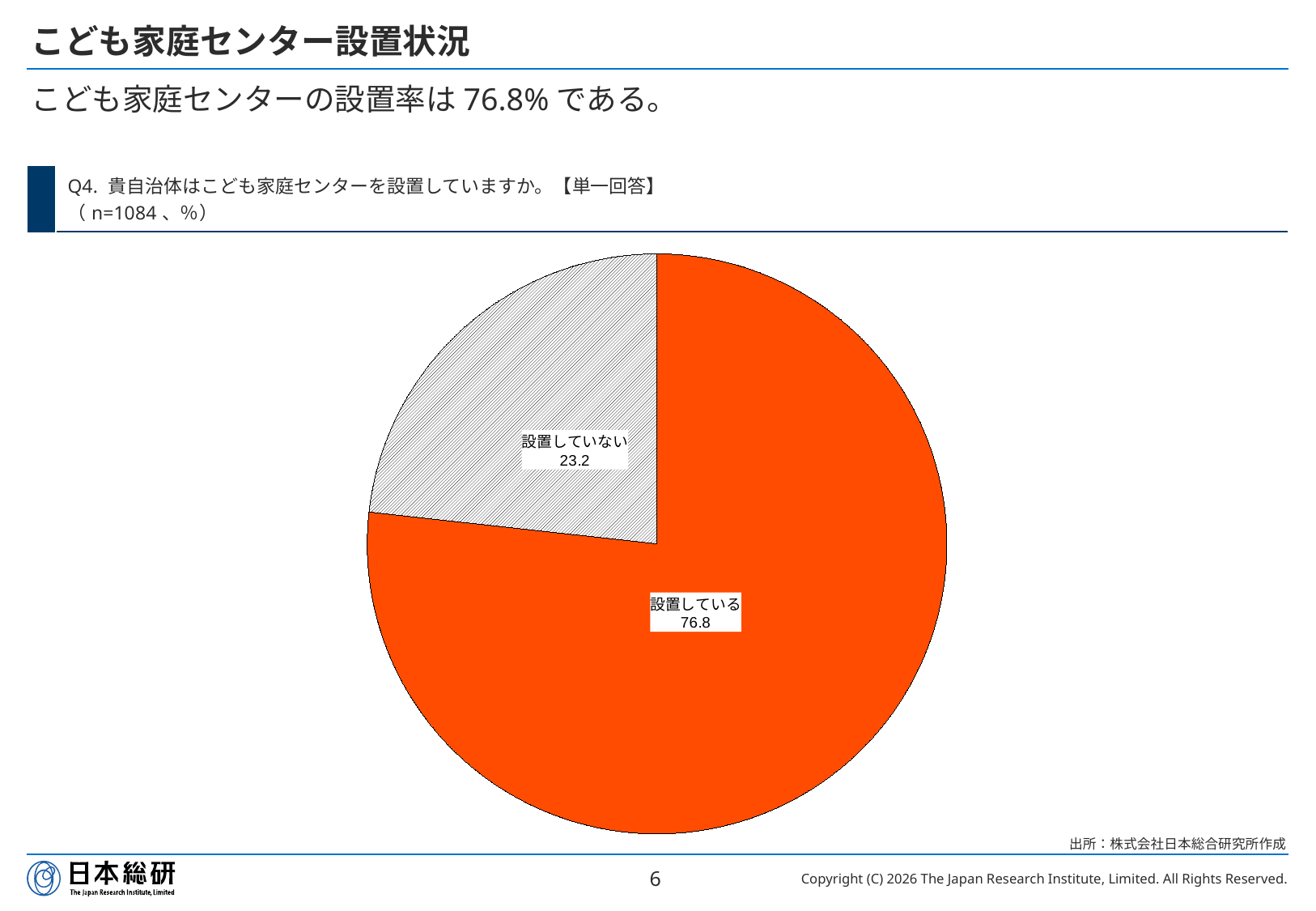
What share of the pie does 設置していない represent? 23.2% What is the sample size (n) shown for the chart? 1084 What is the difference between the values for 設置している and 設置していない? 53.6 What is the value for 設置している? 76.8 Which slice is the smallest? 設置していない Which slice is the largest? 設置している Which is larger, 設置している or 設置していない? 設置している What kind of chart is shown on the slide? pie chart How many slices does the pie chart have? 2 What is the value for 設置していない? 23.2 Which slice is drawn with a hatched pattern? 設置していない